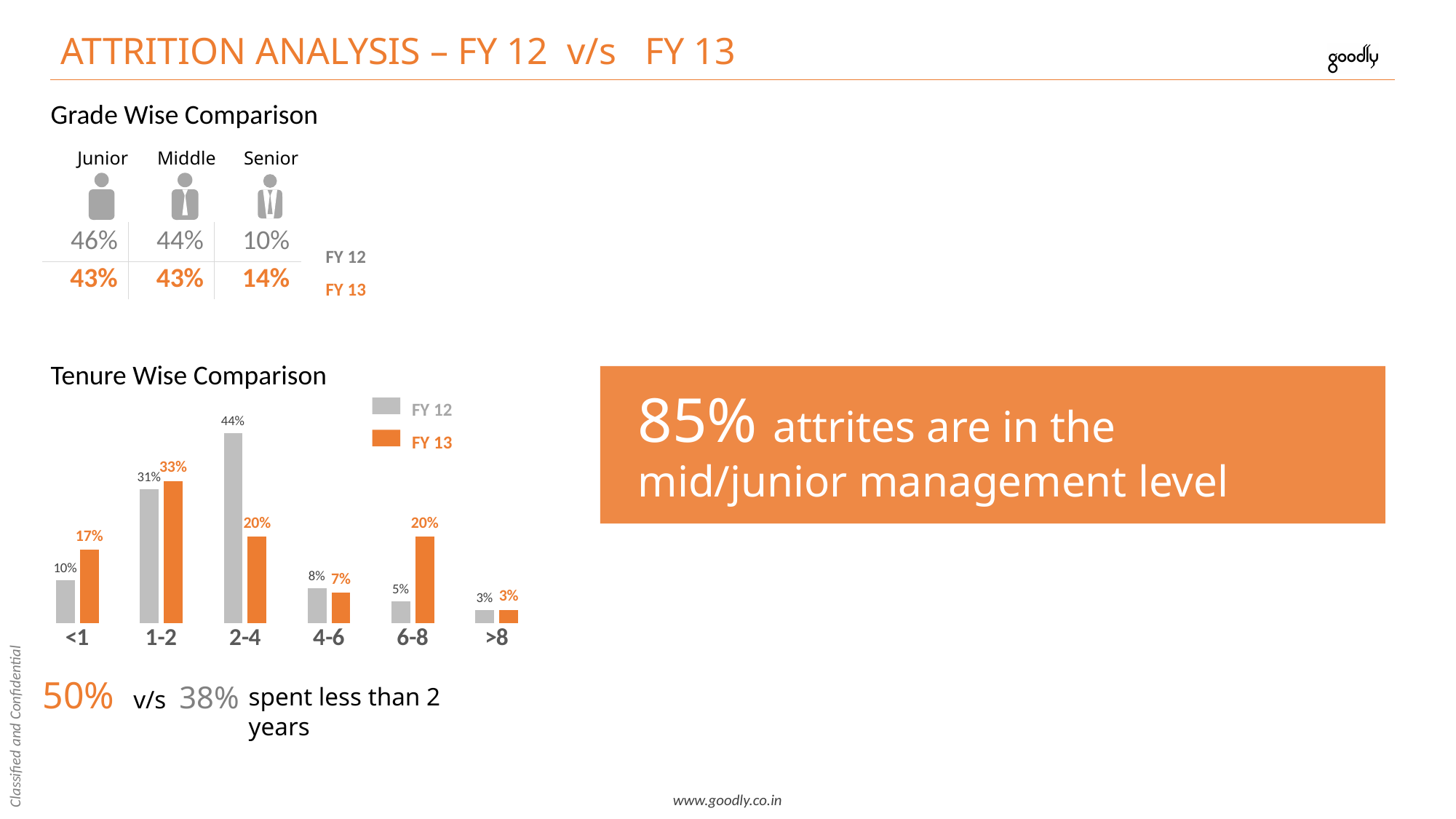
In the Tenure Wise Comparison chart, which is larger for the 4-6 tenure group, FY 12 or FY 13? FY 12 How many tenure groups are shown on the x axis of the Tenure Wise Comparison chart? 6 In the Tenure Wise Comparison chart, which tenure group has the highest FY 12 value? 2-4 In the Tenure Wise Comparison chart, which tenure group has the lowest FY 13 value? >8 In the Tenure Wise Comparison chart, what is the difference between the FY 12 and FY 13 values for the 2-4 tenure group? 24% What kind of chart is the Tenure Wise Comparison chart? Bar chart In the Tenure Wise Comparison chart, what is the FY 13 value for the 6-8 tenure group? 20% How many series does the legend of the Tenure Wise Comparison chart list? 2 In the Tenure Wise Comparison chart, what is the FY 12 value for the 2-4 tenure group? 44% In the Tenure Wise Comparison chart, what is the difference between the FY 13 and FY 12 values for the 6-8 tenure group? 15% In the Tenure Wise Comparison chart, which is larger for the 1-2 tenure group, FY 12 or FY 13? FY 13 In the Tenure Wise Comparison chart, what is the FY 13 value for the <1 tenure group? 17%